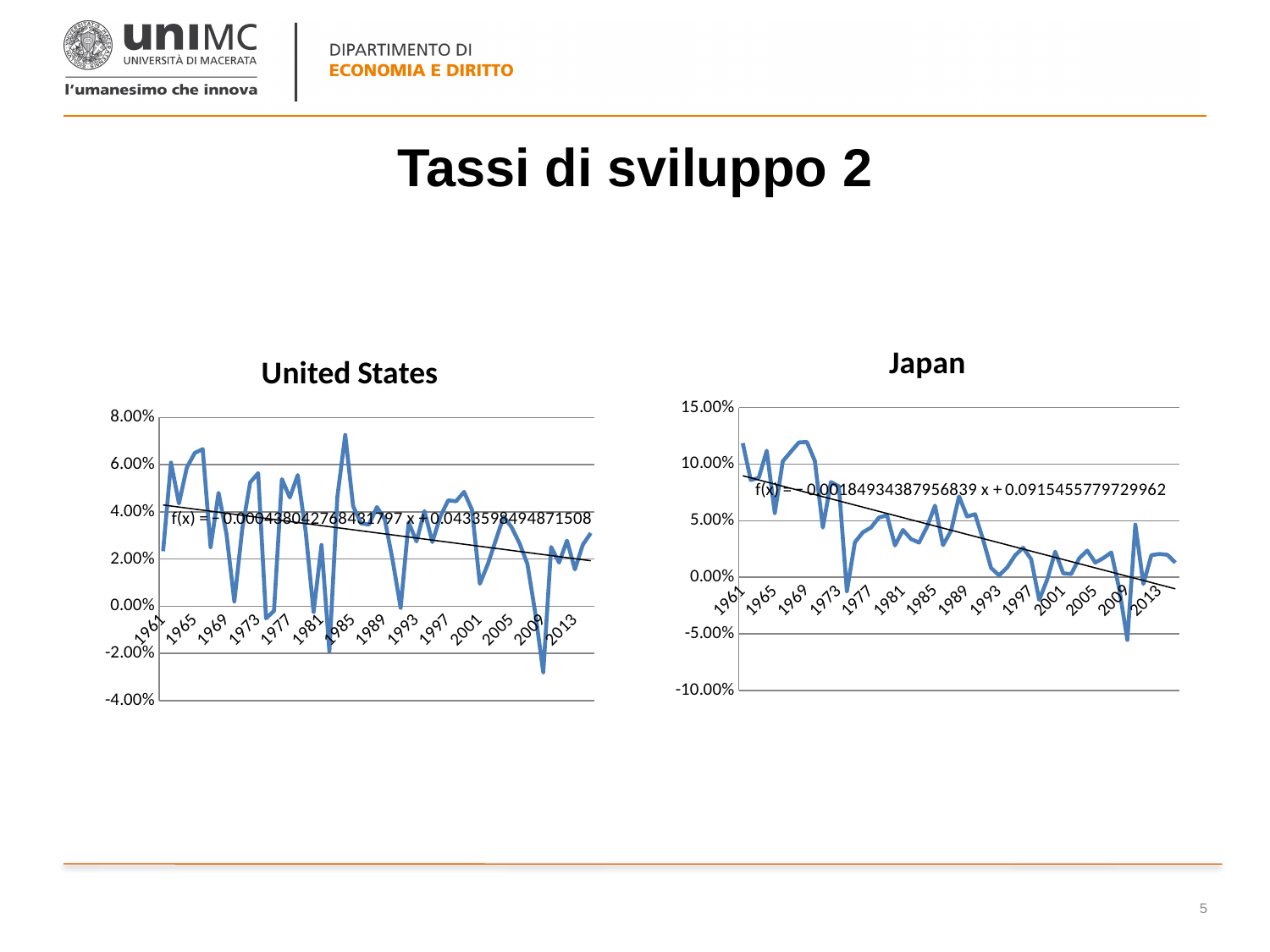
In the United States chart, does the fitted trend line rise or fall from 1961 to 2013? fall In the Japan chart, is the value for 1961 greater or less than 10.00%? greater In the United States chart, is the value for 2009 greater or less than 0.00%? less How many charts are shown on the slide? 2 In the Japan chart, what is the highest value shown on the vertical axis? 15.00% In the United States chart, is the value for 1984 greater or less than 6.00%? greater What kind of chart is the United States chart? line chart In the United States chart, what is the lowest value shown on the vertical axis? -4.00% In the Japan chart, what is the intercept (constant term) of the trend line equation f(x)? 0.0915455779729962 What kind of chart is the Japan chart? line chart In the Japan chart, does the fitted trend line rise or fall from 1961 to 2013? fall